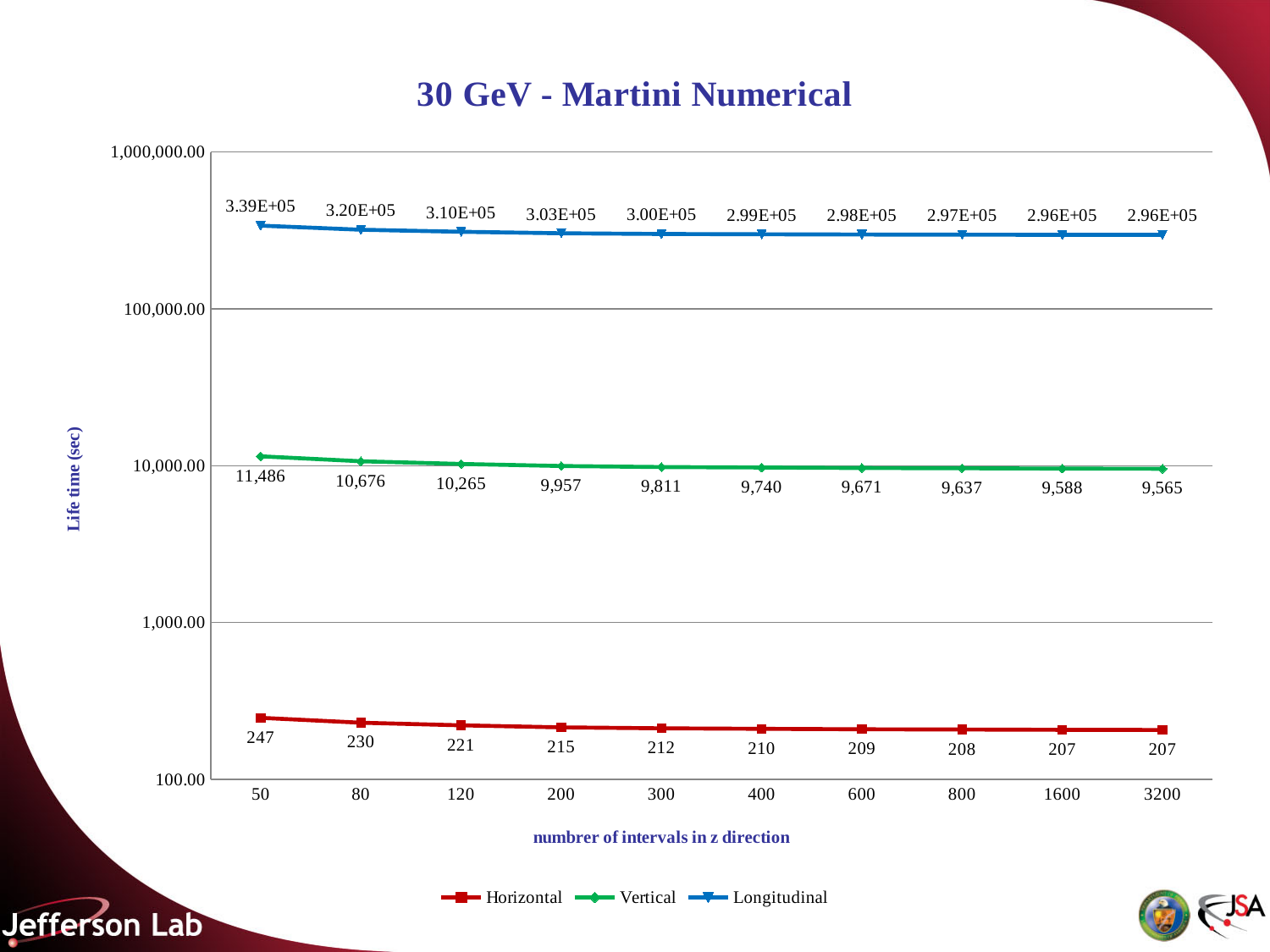
Which is larger, the Horizontal life time at 80 intervals or at 120 intervals? 80 intervals What is the Vertical life time at 200 intervals in z direction? 9,957 How many x-axis categories (numbers of intervals) are plotted? 10 What is the Horizontal life time at 50 intervals in z direction? 247 What is the difference between the Vertical life time at 50 intervals and at 80 intervals? 810 What is the Vertical life time at 3200 intervals in z direction? 9,565 At which number of intervals is the Horizontal life time highest? 50 How many series does the legend list? 3 What is the Longitudinal life time at 50 intervals in z direction? 3.39E+05 Does the Horizontal life time rise or fall as the number of intervals increases? Fall What kind of chart is shown on the slide? Line chart At which number of intervals is the Vertical life time lowest? 3200